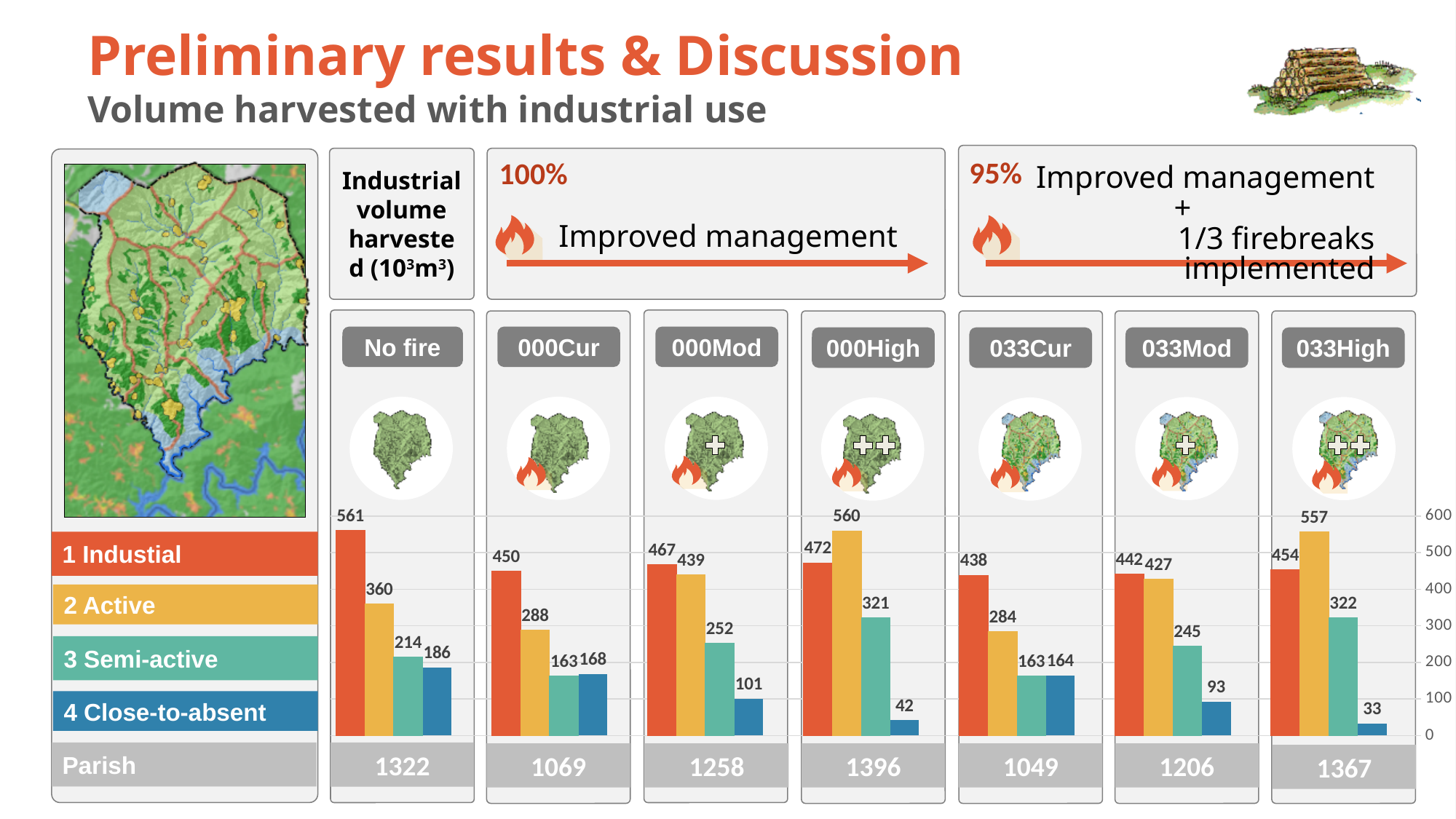
In the "000Cur" chart, what is the difference between 1 Industrial and 2 Active? 162 In the "033High" chart, which category has the lowest value? 4 Close-to-absent Which colour represents 2 Active in the charts? yellow How many bars are shown in the "033Cur" chart? 4 In the "000High" chart, is the value for 4 Close-to-absent greater or less than 100? less What kind of chart is used in the "No fire" panel? bar chart In the "000High" chart, what is the value for 2 Active? 560 In the "000Mod" chart, which category has the highest value? 1 Industrial What is the Parish total shown under the "000High" chart? 1396 In the "033Cur" chart, which is larger: 3 Semi-active or 4 Close-to-absent? 4 Close-to-absent In the "No fire" chart, what is the value for 1 Industrial? 561 In the "033Mod" chart, what is the value for 3 Semi-active? 245